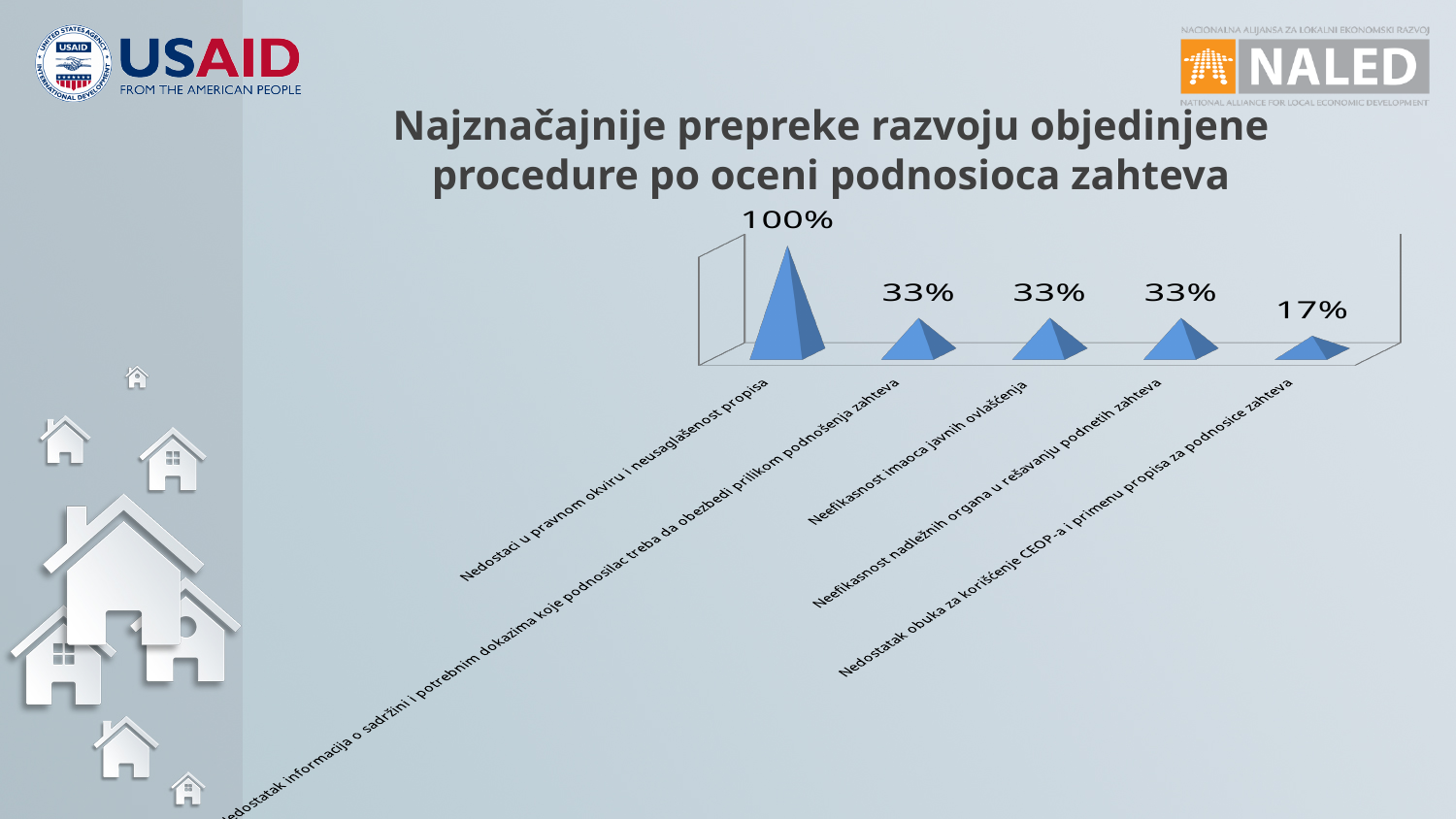
What is the value for "Neefikasnost nadležnih organa u rešavanju podnetih zahteva"? 33% Which category has the highest value? Nedostaci u pravnom okviru i neusaglašenost propisa What is the value for "Nedostatak obuka za korišćenje CEOP-a i primenu propisa za podnosice zahteva"? 17% What is the difference between the value for "Neefikasnost nadležnih organa u rešavanju podnetih zahteva" and the value for "Nedostatak obuka za korišćenje CEOP-a i primenu propisa za podnosice zahteva"? 16% Which category has the lowest value? Nedostatak obuka za korišćenje CEOP-a i primenu propisa za podnosice zahteva What is the title of the chart? Najznačajnije prepreke razvoju objedinjene procedure po oceni podnosioca zahteva Which is larger: the value for "Neefikasnost imaoca javnih ovlašćenja" or the value for "Nedostatak obuka za korišćenje CEOP-a i primenu propisa za podnosice zahteva"? Neefikasnost imaoca javnih ovlašćenja What is the difference between the value for "Nedostaci u pravnom okviru i neusaglašenost propisa" and the value for "Neefikasnost imaoca javnih ovlašćenja"? 67% What is the value for "Nedostaci u pravnom okviru i neusaglašenost propisa"? 100% What kind of chart is shown on the slide? bar chart How many categories are shown in the chart? 5 What is the value for "Neefikasnost imaoca javnih ovlašćenja"? 33%